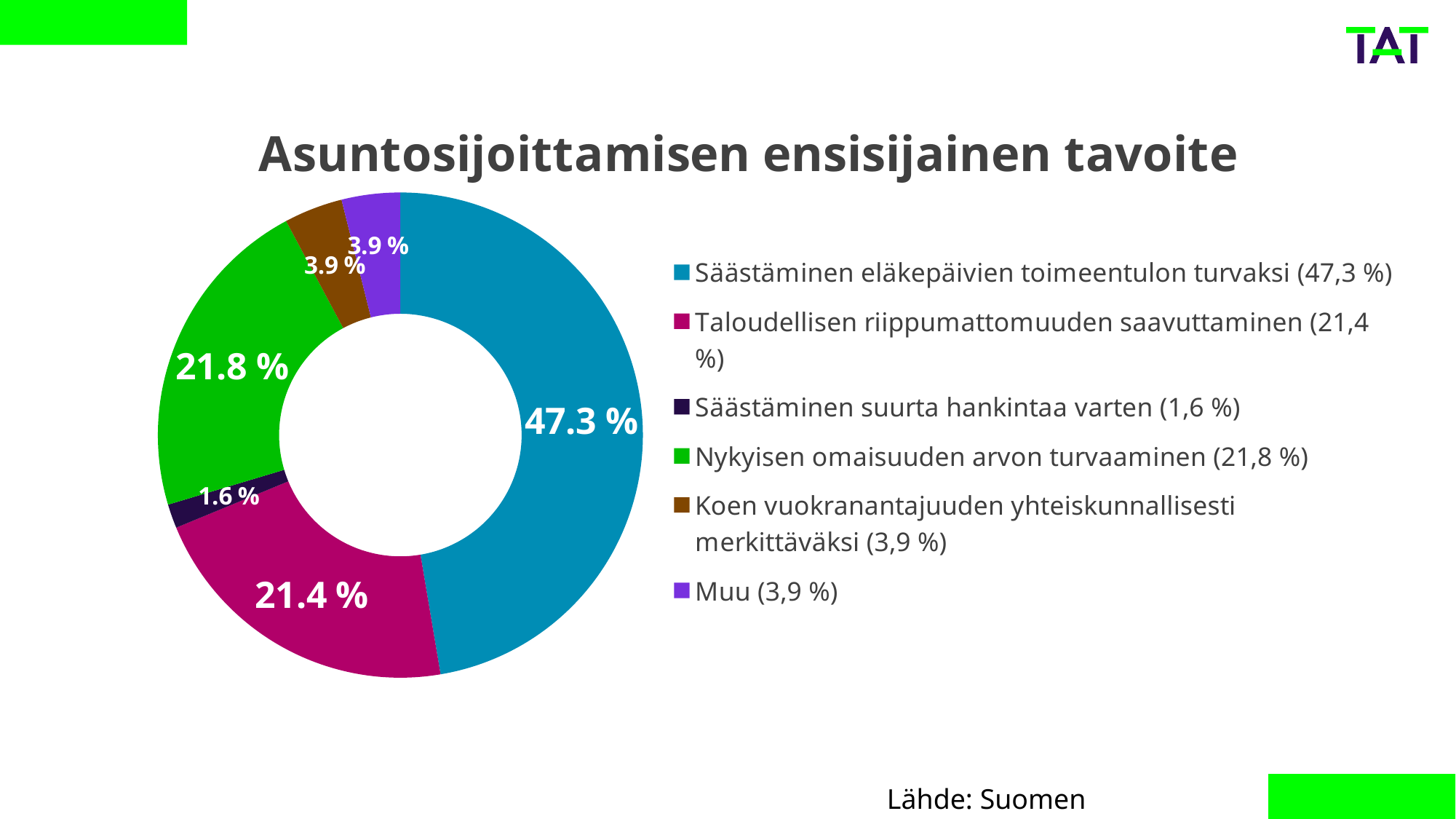
Which category has the largest share of the chart? Säästäminen eläkepäivien toimeentulon turvaksi What is the value for 'Nykyisen omaisuuden arvon turvaaminen'? 21.8 % Which category has the smallest share of the chart? Säästäminen suurta hankintaa varten What is the title of the chart? Asuntosijoittamisen ensisijainen tavoite What is the value for 'Säästäminen eläkepäivien toimeentulon turvaksi'? 47.3 % What kind of chart is shown on the slide? Doughnut (pie) chart Which colour represents 'Koen vuokranantajuuden yhteiskunnallisesti merkittäväksi' in the chart? Brown What is the difference between the values for 'Säästäminen eläkepäivien toimeentulon turvaksi' and 'Nykyisen omaisuuden arvon turvaaminen'? 25.5 % What is the value for 'Taloudellisen riippumattomuuden saavuttaminen'? 21.4 % What is the value for 'Muu'? 3.9 % What is the value for 'Säästäminen suurta hankintaa varten'? 1.6 % How many categories does the legend list? 6